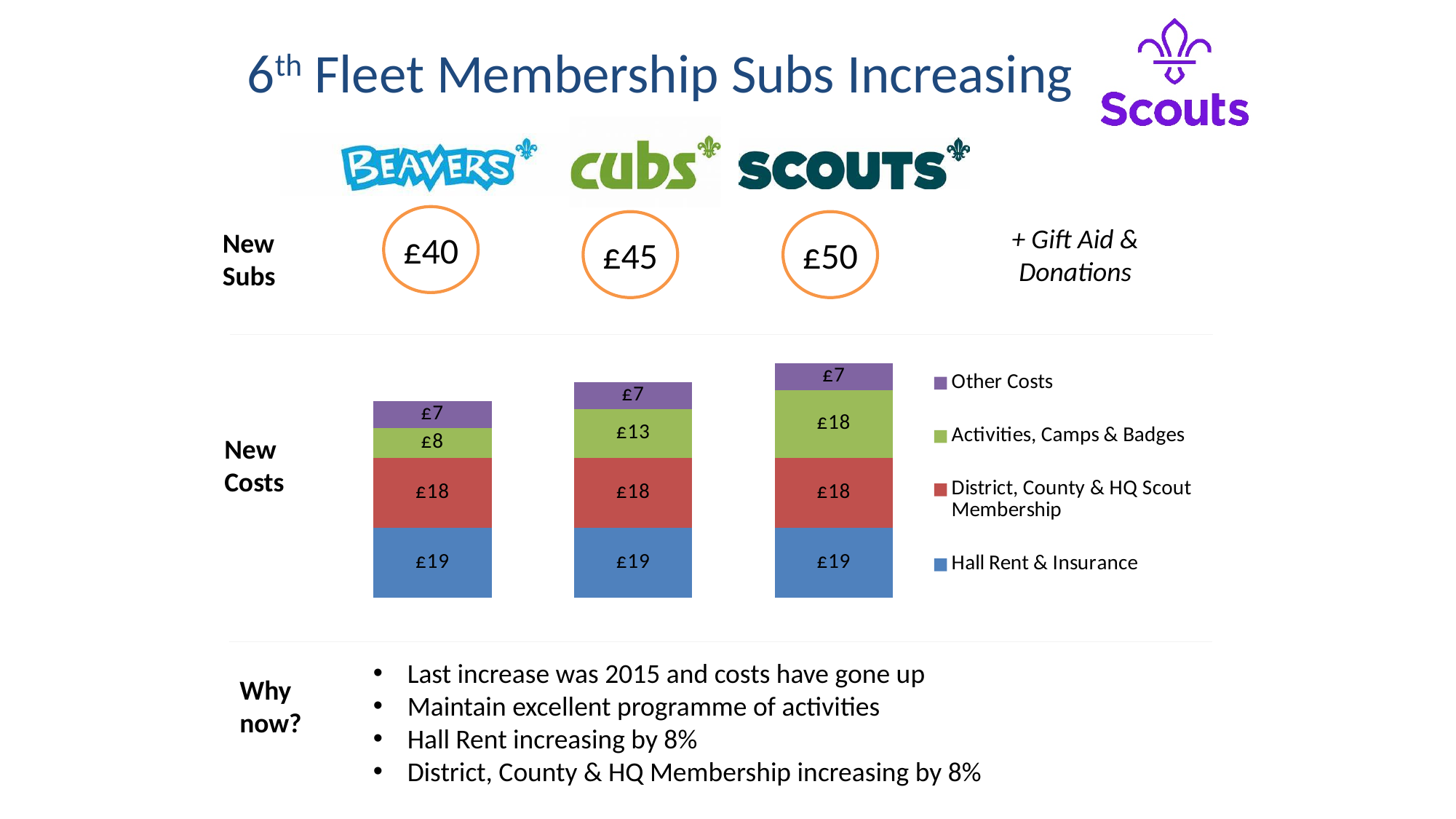
In the New Costs chart, what is the Activities, Camps & Badges value for Cubs? £13 In the New Costs chart, what is the Other Costs value for Beavers? £7 In the New Costs chart, which section has the highest Activities, Camps & Badges cost? Scouts In the New Costs chart, which section has the lowest Activities, Camps & Badges cost? Beavers What kind of chart is shown in the New Costs section? Stacked bar chart In the New Costs chart, which legend entry is shown in blue? Hall Rent & Insurance How many bars are in the New Costs chart? 3 How many series does the legend of the New Costs chart list? 4 In the New Costs chart, what is the Hall Rent & Insurance value for Scouts? £19 In the New Costs chart, what is the total cost for the Beavers bar? £52 In the New Costs chart, what is the total cost for the Cubs bar? £57 In the New Costs chart, what is the difference between the Activities, Camps & Badges cost for Scouts and for Beavers? £10